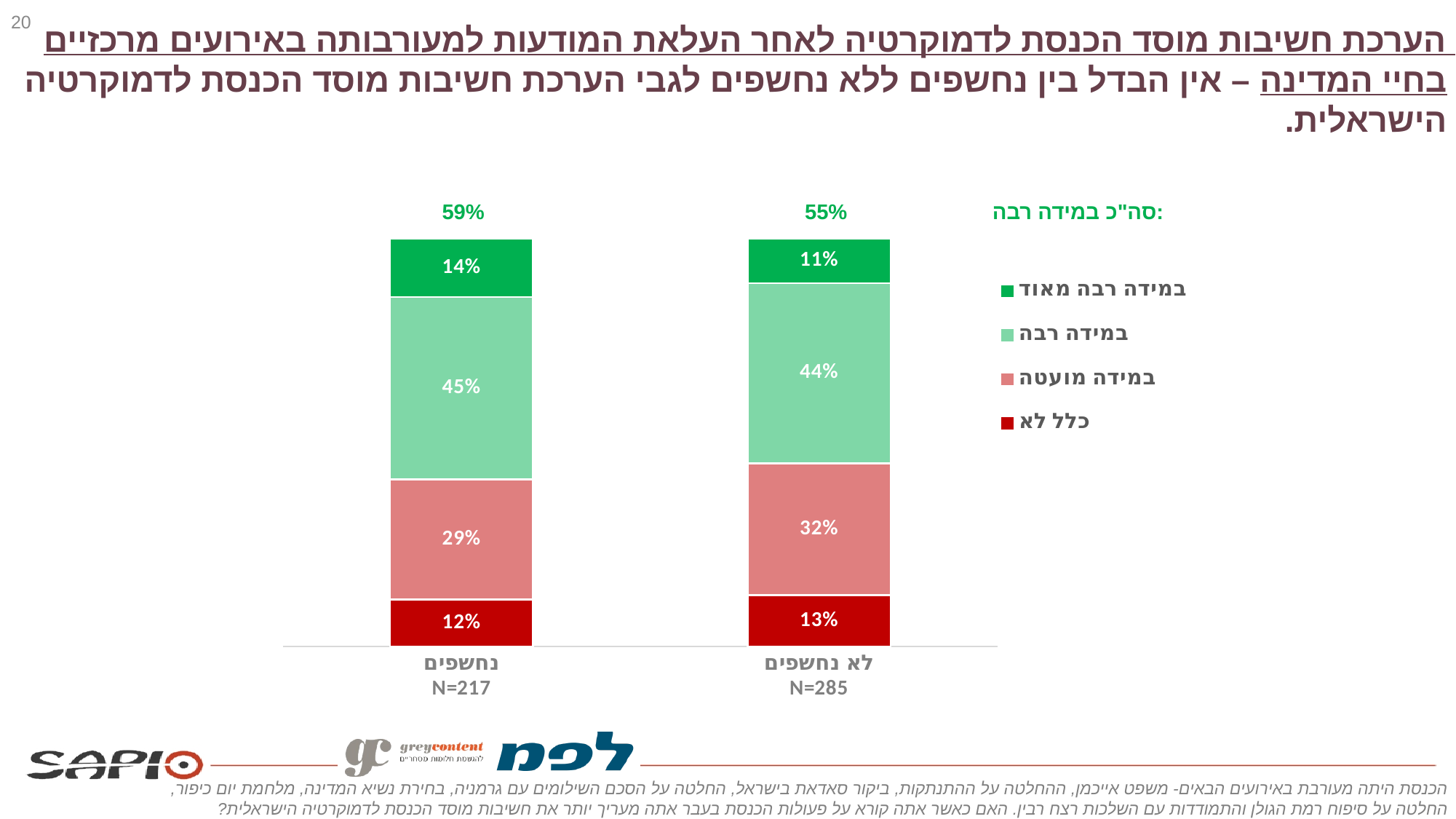
What is the value of the 'במידה מועטה' segment for the 'לא נחשפים' bar? 32% What kind of chart is shown on the slide? stacked bar chart What is the difference between the 'במידה מועטה' values for 'לא נחשפים' and 'נחשפים'? 3% What is the value of the 'במידה רבה מאוד' segment for the 'נחשפים' bar? 14% What is the combined 'סה"כ במידה רבה' total shown above the 'נחשפים' bar? 59% What is the combined 'סה"כ במידה רבה' total shown above the 'לא נחשפים' bar? 55% What sample size (N) is shown for the 'לא נחשפים' bar? N=285 Which bar has the larger 'במידה רבה מאוד' segment, 'נחשפים' or 'לא נחשפים'? נחשפים What is the value of the 'במידה רבה' segment for the 'לא נחשפים' bar? 44% What is the value of the 'כלל לא' segment for the 'נחשפים' bar? 12% How many series does the legend list? 4 How many categories (bars) does the chart show? 2